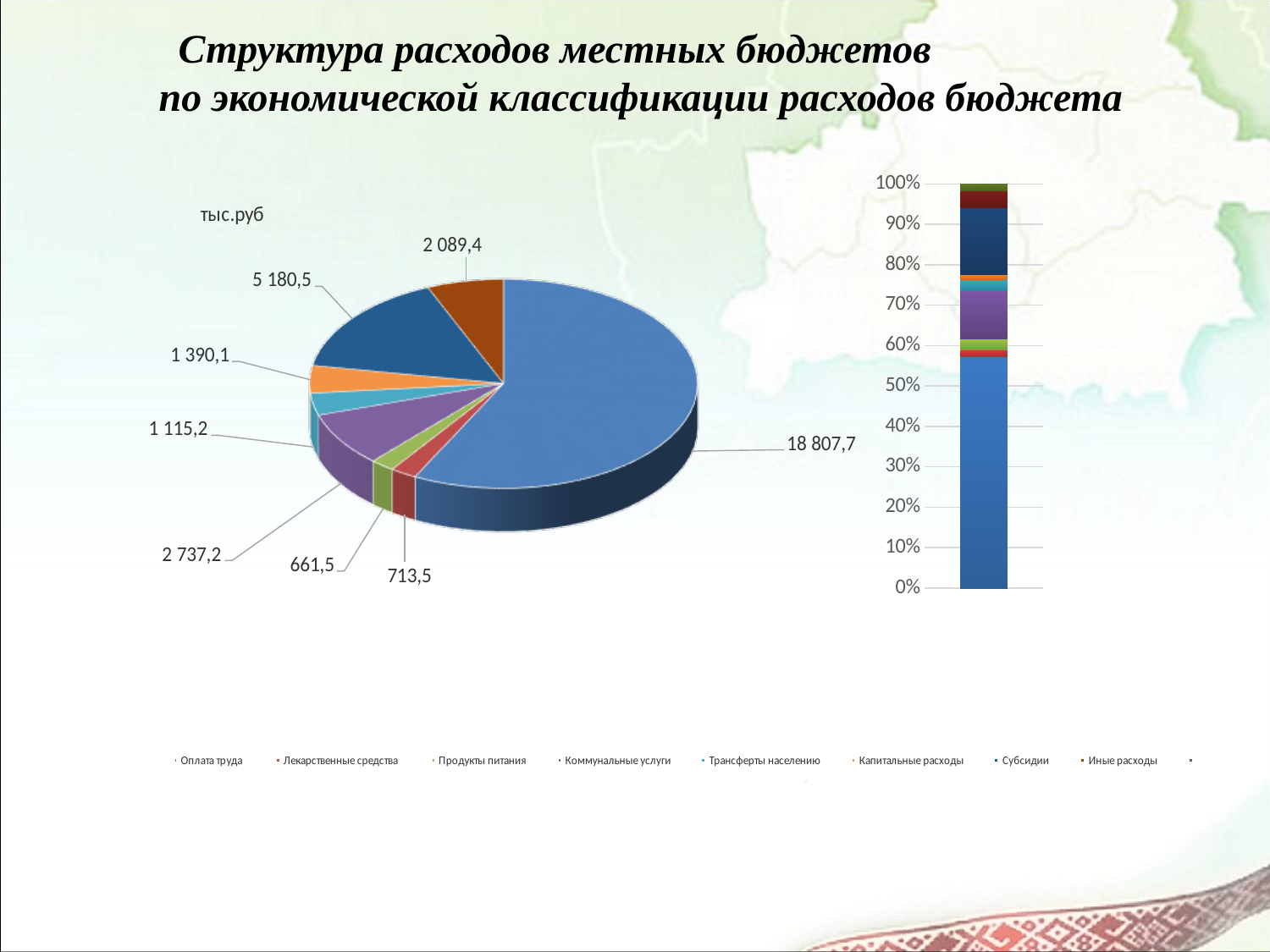
What unit is indicated for the values in the pie chart? тыс.руб What type of chart is shown on the left side of the slide? pie chart What is the first entry listed in the legend at the bottom of the slide? Оплата труда In the pie chart, what is the value of the smallest slice? 661,5 In the pie chart, what is the value of the largest slice? 18 807,7 In the pie chart, what is the value of the dark blue slice labelled next to the top-left of the pie? 5 180,5 In the pie chart, which is larger: the slice labelled 2 737,2 or the slice labelled 2 089,4? 2 737,2 In the pie chart, what is the value of the brown slice at the top of the pie? 2 089,4 In the pie chart, what is the difference between the largest slice (18 807,7) and the slice labelled 5 180,5? 13 627,2 In the stacked bar chart, is the share of the bottom (blue) segment greater or less than 50%? greater What type of chart is shown on the right side of the slide? stacked bar chart How many slices does the pie chart have? 8